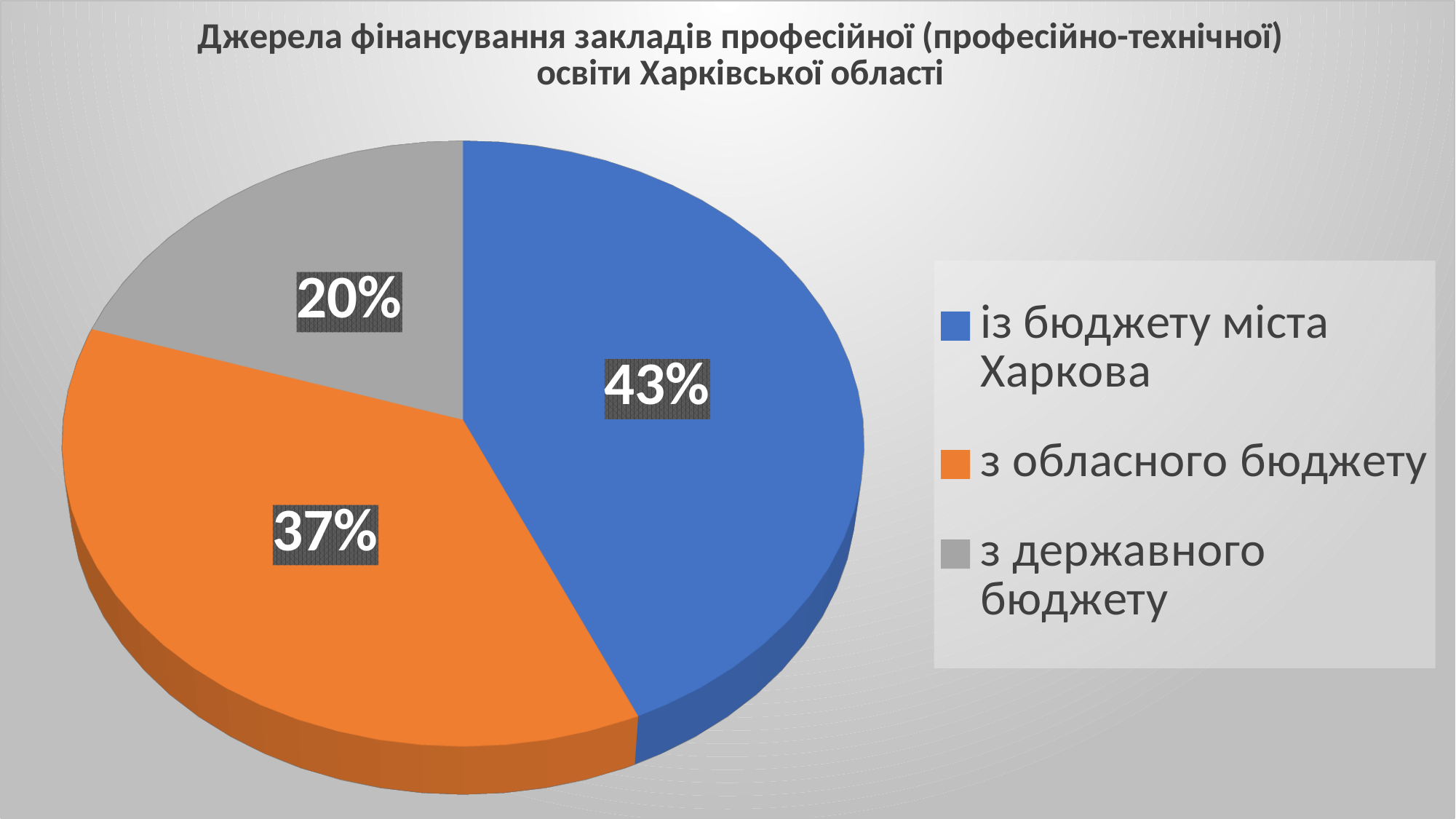
What share of funding comes from the regional budget (з обласного бюджету)? 37% What colour is the slice for the state budget (з державного бюджету)? grey Which funding source has the smallest share? з державного бюджету What is the title of the chart? Джерела фінансування закладів професійної (професійно-технічної) освіти Харківської області What share of funding comes from the Kharkiv city budget (із бюджету міста Харкова)? 43% What is the difference in percentage points between the Kharkiv city budget share and the regional budget share? 6 Which is larger: the share from the regional budget or the share from the state budget? з обласного бюджету What is the difference in percentage points between the regional budget share and the state budget share? 17 What share of funding comes from the state budget (з державного бюджету)? 20% What kind of chart is shown on the slide? pie chart Which funding source has the largest share? із бюджету міста Харкова How many slices does the pie chart have? 3